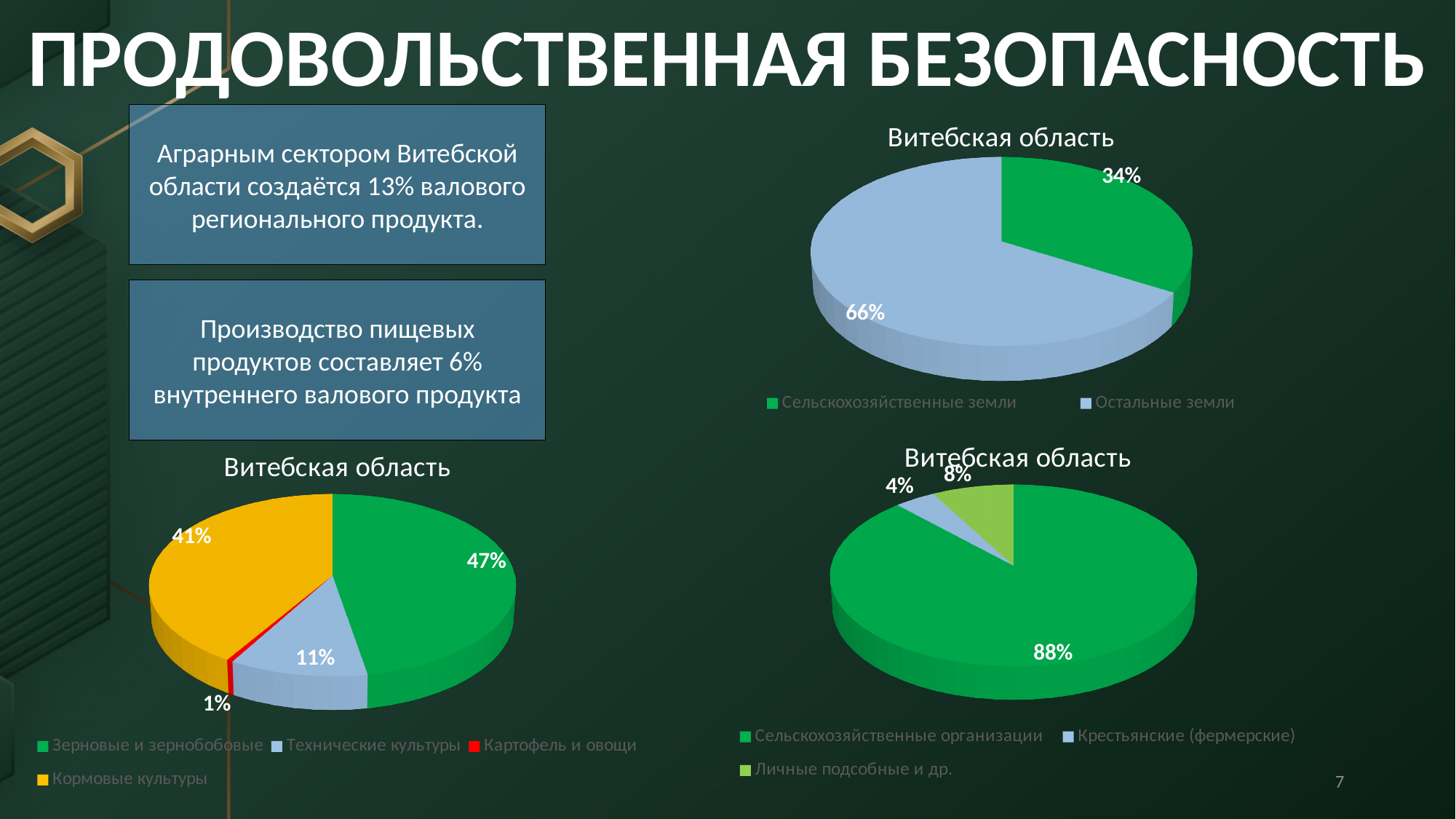
In the bottom-right pie chart, what share is labelled for Крестьянские (фермерские)? 4% In the bottom-right pie chart, what share is labelled for Сельскохозяйственные организации? 88% What type of chart is the top-right chart on the slide? Pie chart In the top-right pie chart, what share is labelled for Сельскохозяйственные земли? 34% In the top-right pie chart, what share is labelled for Остальные земли? 66% In the bottom-left pie chart, which category has the smallest share? Картофель и овощи In the bottom-left pie chart, what share is labelled for Кормовые культуры? 41% In the bottom-left pie chart, what is the difference between the shares of Зерновые и зернобобовые and Технические культуры? 36% In the bottom-right pie chart, which is larger: Личные подсобные и др. or Крестьянские (фермерские)? Личные подсобные и др. How many categories does the legend of the bottom-left pie chart list? 4 In the top-right pie chart, which category has the larger share? Остальные земли In the bottom-left pie chart, what share is labelled for Зерновые и зернобобовые? 47%